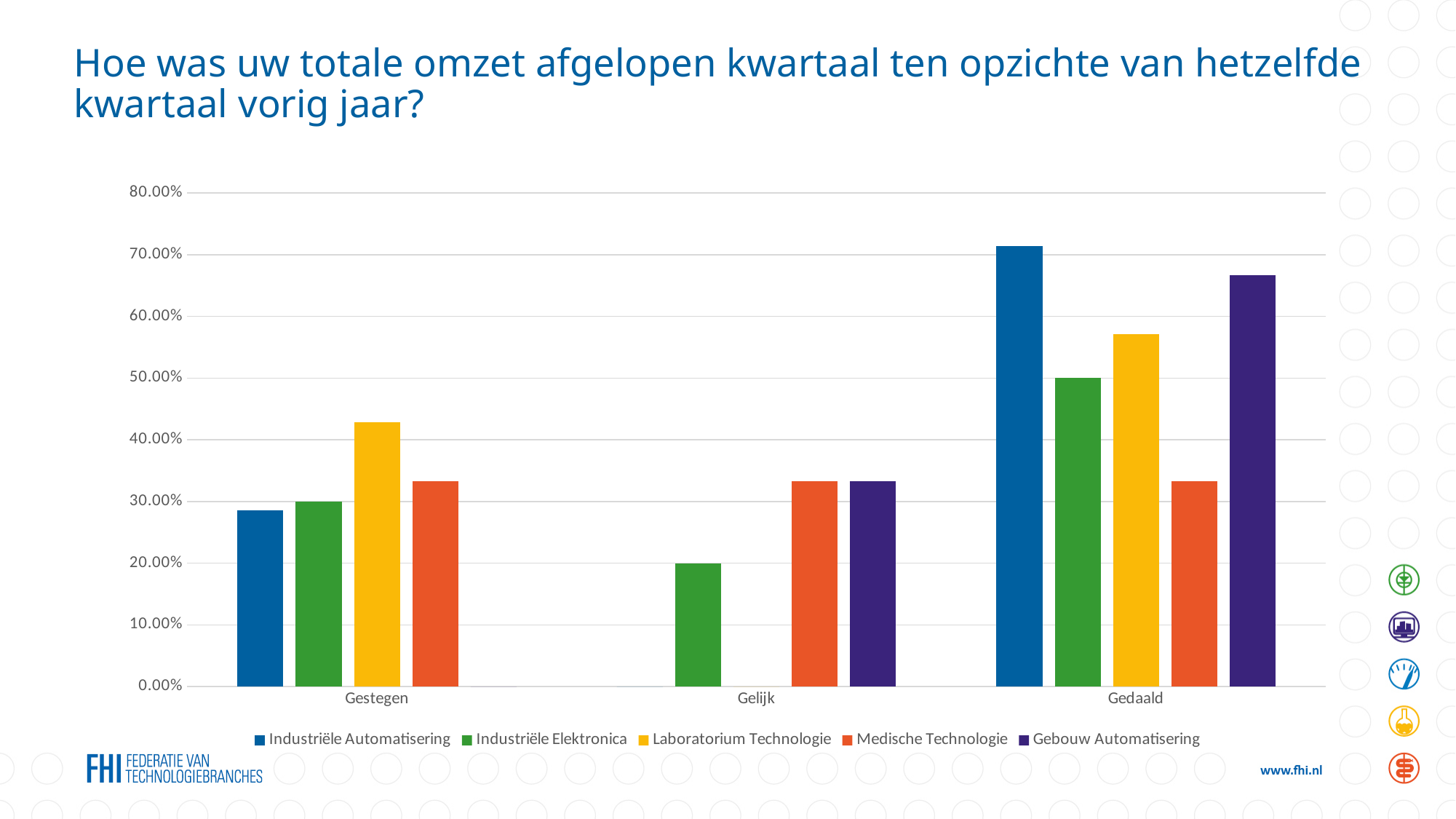
What kind of chart is shown on the slide? bar chart Which series has the highest value in the Gedaald category? Industriële Automatisering Which series has the highest value in the Gestegen category? Laboratorium Technologie How many series does the legend list? 5 What is the value for Industriële Elektronica in the Gelijk category? 20.00% Is the value for Industriële Automatisering in the Gedaald category greater or less than 60.00%? greater In the Gestegen category, which is larger: Medische Technologie or Industriële Automatisering? Medische Technologie How many categories are shown on the x axis? 3 Is the value for Gebouw Automatisering in the Gedaald category greater or less than 60.00%? greater In the Gedaald category, which is larger: Laboratorium Technologie or Industriële Elektronica? Laboratorium Technologie Is the value for Laboratorium Technologie in the Gestegen category greater or less than 40.00%? greater What is the value for Industriële Elektronica in the Gedaald category? 50.00%